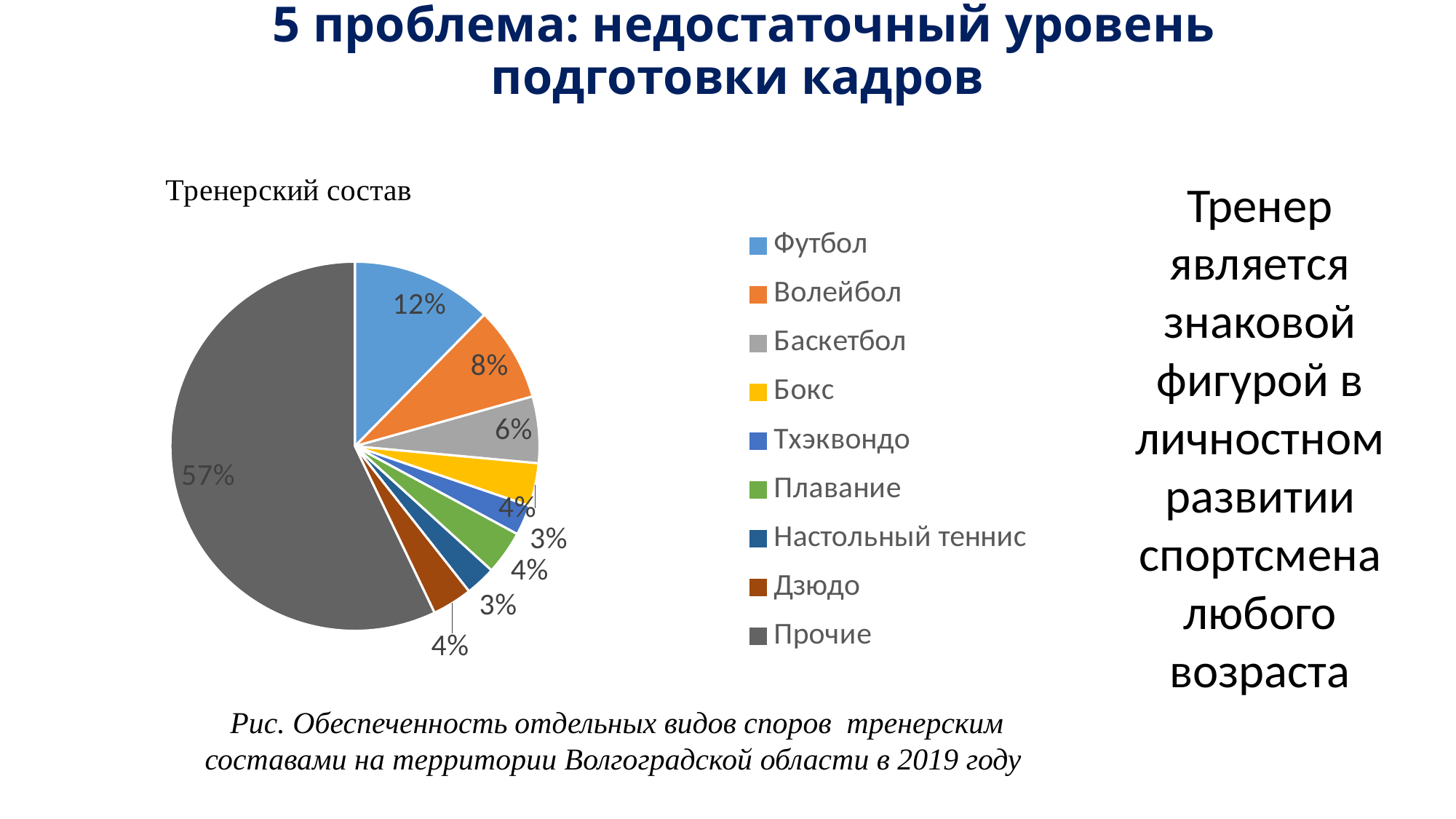
What share of the pie does Волейбол have? 8% What share of the pie does Дзюдо have? 4% What is the difference between the shares of Футбол and Баскетбол? 6% What is the title of the chart? Тренерский состав Which has the larger share, Футбол or Волейбол? Футбол What share of the pie does Баскетбол have? 6% Which category has the largest slice of the pie? Прочие What share of the pie does Футбол have? 12% What kind of chart is shown on the slide? pie chart What share of the pie does Прочие have? 57% What colour is the slice for Бокс? yellow How many categories does the legend list? 9